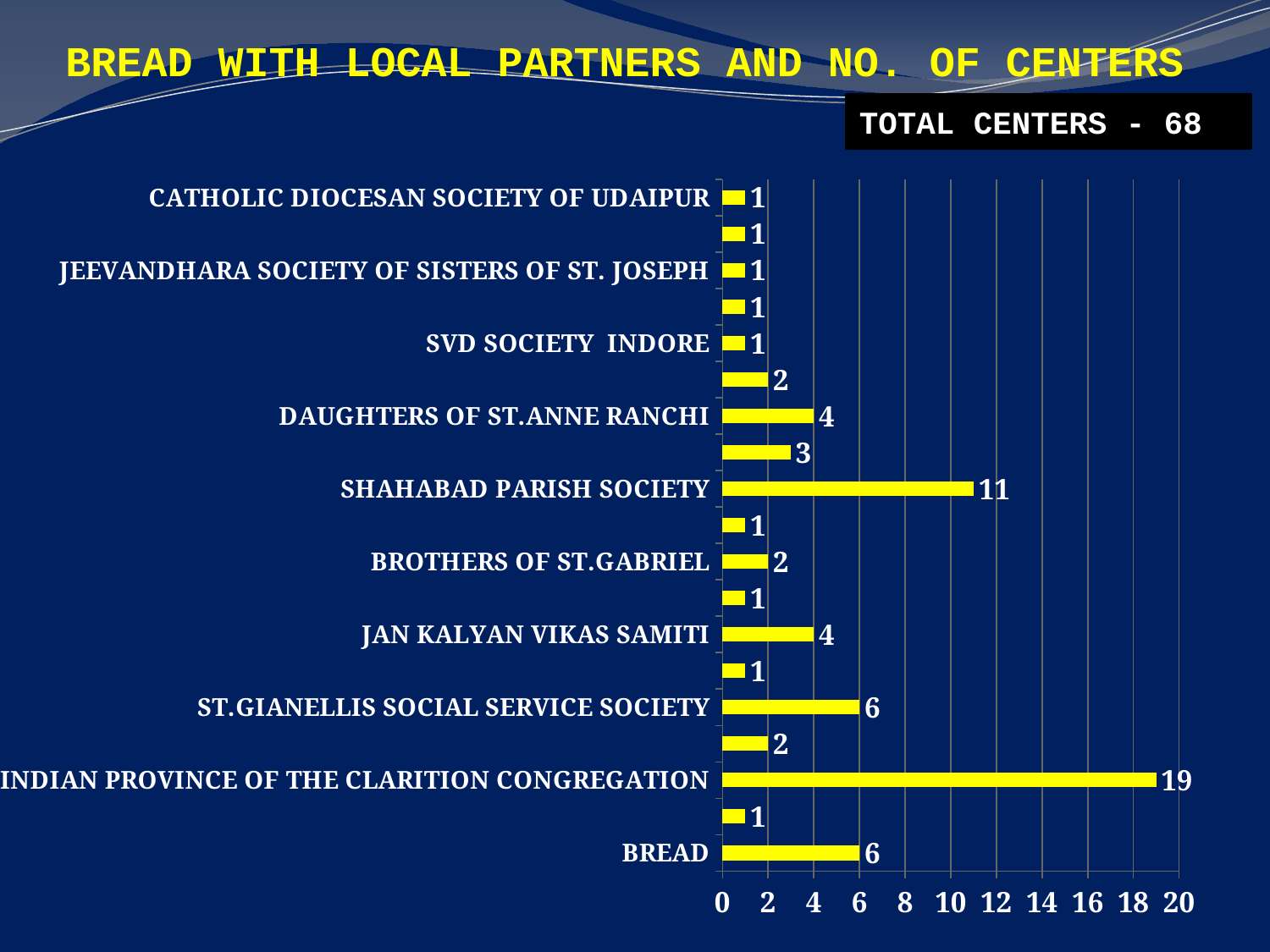
How many centers does BREAD have? 6 What type of chart is shown on the slide? bar chart How many centers does INDIAN PROVINCE OF THE CLARITION CONGREGATION have? 19 Which partner has the highest number of centers? INDIAN PROVINCE OF THE CLARITION CONGREGATION How many centers does BROTHERS OF ST.GABRIEL have? 2 What total number of centers is stated on the slide? 68 What is the title of the slide? BREAD WITH LOCAL PARTNERS AND NO. OF CENTERS How many centers does DAUGHTERS OF ST.ANNE RANCHI have? 4 How many bars are plotted in the chart? 19 Which has more centers, ST.GIANELLIS SOCIAL SERVICE SOCIETY or JAN KALYAN VIKAS SAMITI? ST.GIANELLIS SOCIAL SERVICE SOCIETY What is the difference in centers between INDIAN PROVINCE OF THE CLARITION CONGREGATION and SHAHABAD PARISH SOCIETY? 8 How many centers does SHAHABAD PARISH SOCIETY have? 11